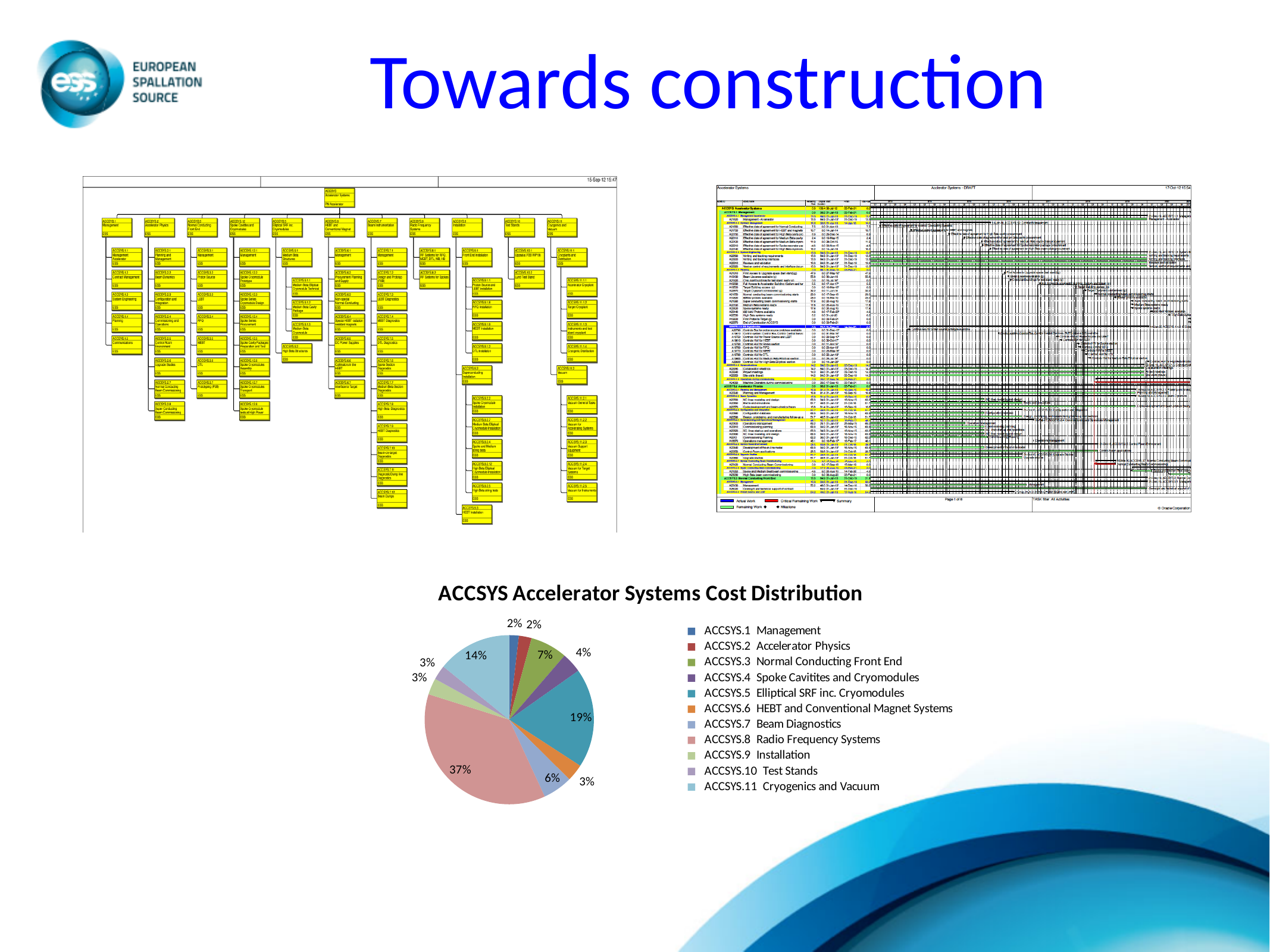
In the ACCSYS Accelerator Systems Cost Distribution pie chart, what share is ACCSYS.8 Radio Frequency Systems? 37% In the ACCSYS Accelerator Systems Cost Distribution pie chart, what is the difference between the shares of ACCSYS.8 Radio Frequency Systems and ACCSYS.5 Elliptical SRF inc. Cryomodules? 18% What kind of chart is the ACCSYS Accelerator Systems Cost Distribution chart? pie chart In the ACCSYS Accelerator Systems Cost Distribution pie chart, what share is ACCSYS.11 Cryogenics and Vacuum? 14% How many categories does the legend of the ACCSYS Accelerator Systems Cost Distribution pie chart list? 11 Which category has the largest slice in the ACCSYS Accelerator Systems Cost Distribution pie chart? ACCSYS.8 Radio Frequency Systems What is the title of the pie chart on the slide? ACCSYS Accelerator Systems Cost Distribution In the ACCSYS Accelerator Systems Cost Distribution pie chart, which is larger: ACCSYS.11 Cryogenics and Vacuum or ACCSYS.3 Normal Conducting Front End? ACCSYS.11 Cryogenics and Vacuum In the ACCSYS Accelerator Systems Cost Distribution pie chart, what share is ACCSYS.3 Normal Conducting Front End? 7%